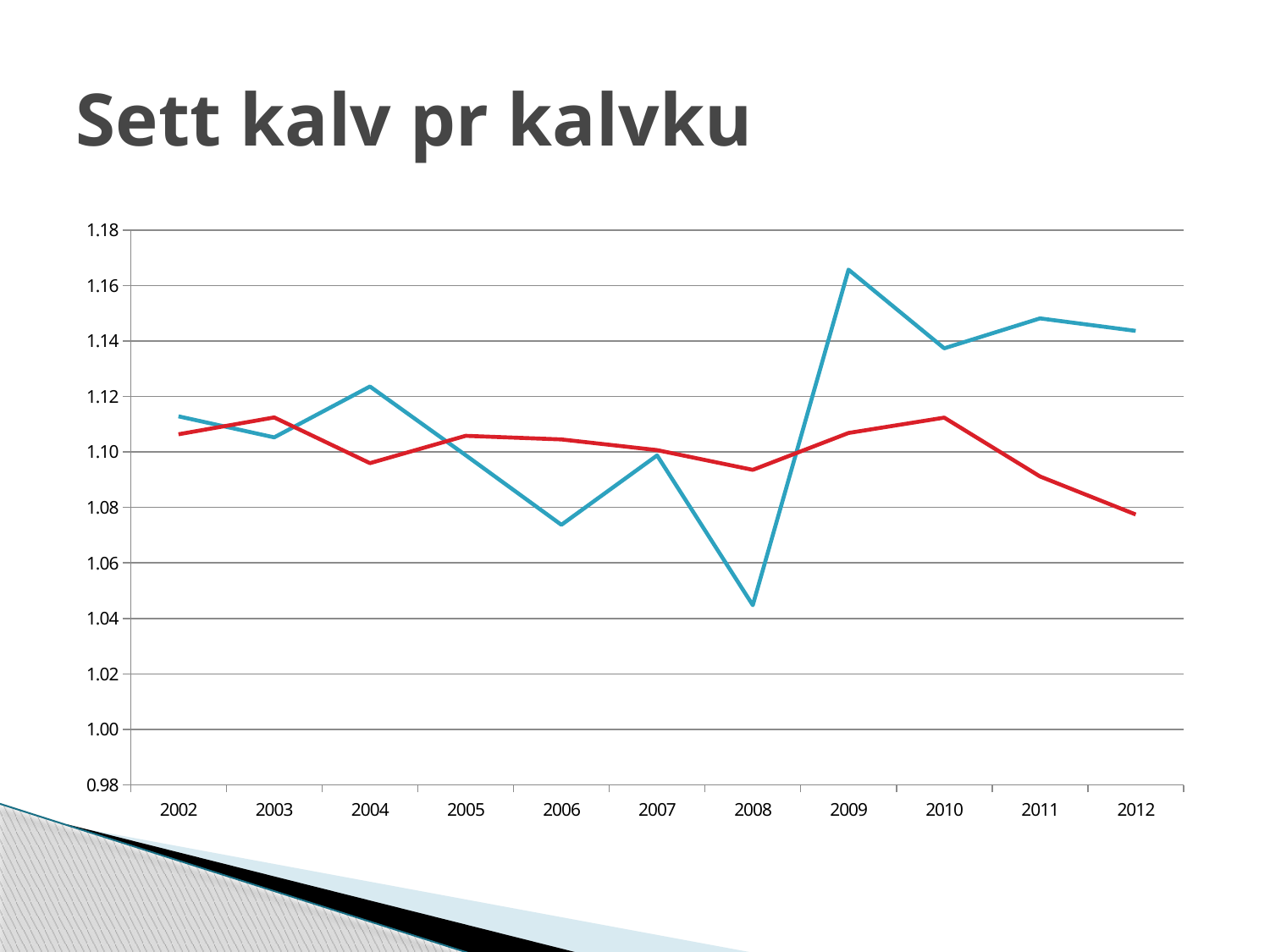
In 2006, which line has the higher value, the blue line or the red line? the red line How many years are shown along the x axis of the chart? 11 In 2012, which line has the higher value, the blue line or the red line? the blue line Is the value of the blue line in 2008 greater or less than 1.06? less In which year does the red line reach its lowest value? 2012 What is the title of the chart on the slide? Sett kalv pr kalvku In which year does the blue line reach its lowest value? 2008 Does the red line rise or fall from 2010 to 2012? fall In which year does the blue line reach its highest value? 2009 Is the value of the blue line in 2009 greater or less than 1.16? greater What kind of chart is shown on the slide? line chart